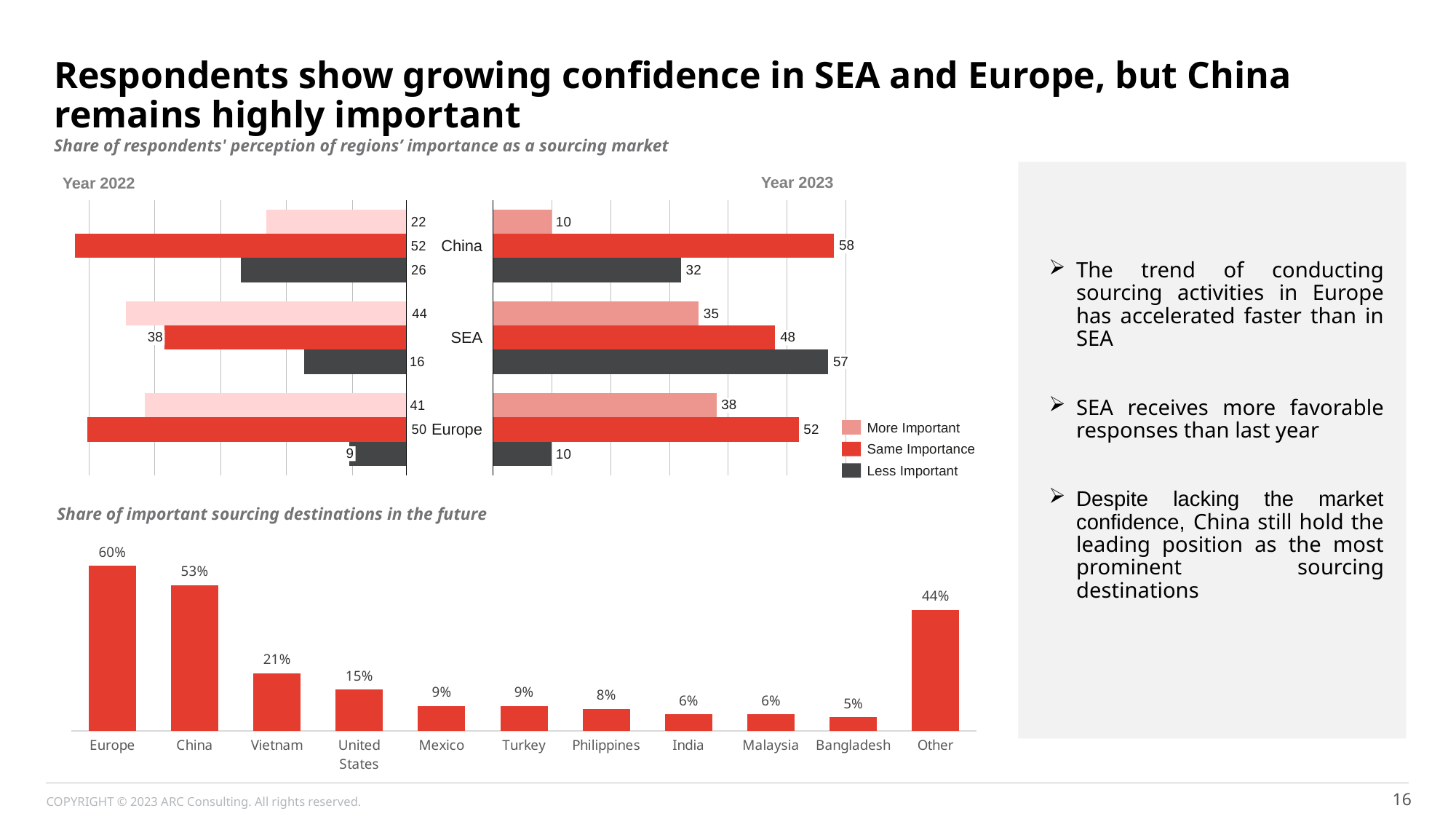
In the top chart, for Year 2023, which has the larger 'More Important' value: SEA or Europe? Europe In the top chart, what is the Year 2022 'Less Important' value for Europe? 9 In the bottom chart, what is the share for Vietnam? 21% In the bottom chart (Share of important sourcing destinations in the future), which destination has the highest share? Europe What kind of chart is the bottom chart? Bar chart In the top chart (Share of respondents' perception of regions' importance as a sourcing market), what is the Year 2023 'Same Importance' value for China? 58 How many destination categories are shown in the bottom chart? 11 In the bottom chart, what is the difference between the shares for Europe and China? 7% In the top chart, what is the Year 2022 'More Important' value for SEA? 44 In the bottom chart, which destination has the lowest share? Bangladesh How many series does the legend of the top chart list? 3 In the top chart, by how much did the 'Less Important' value for SEA increase from Year 2022 to Year 2023? 41